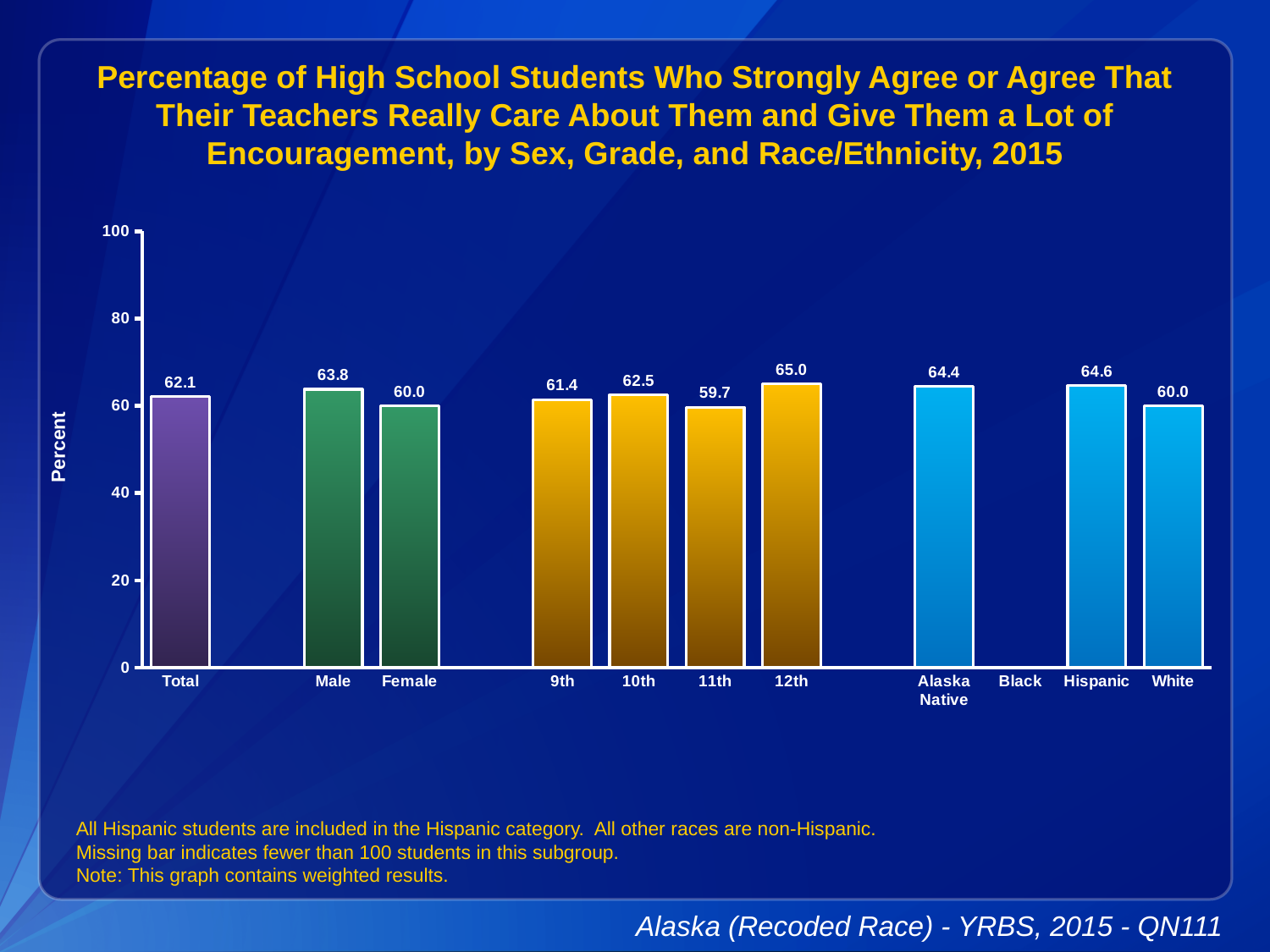
What is the difference between the Male and Female values? 3.8 Which grade has the highest value? 12th What is the value for Alaska Native? 64.4 Which category has the lowest value on the chart? 11th Is the value for 12th grade greater or less than 80? less What kind of chart is shown? bar chart What is the value for 11th grade? 59.7 What is the value for Male? 63.8 Which race/ethnicity category has no bar shown? Black Which is larger, the value for Hispanic or the value for White? Hispanic How many bars are plotted on the chart? 10 What is the value for Total? 62.1